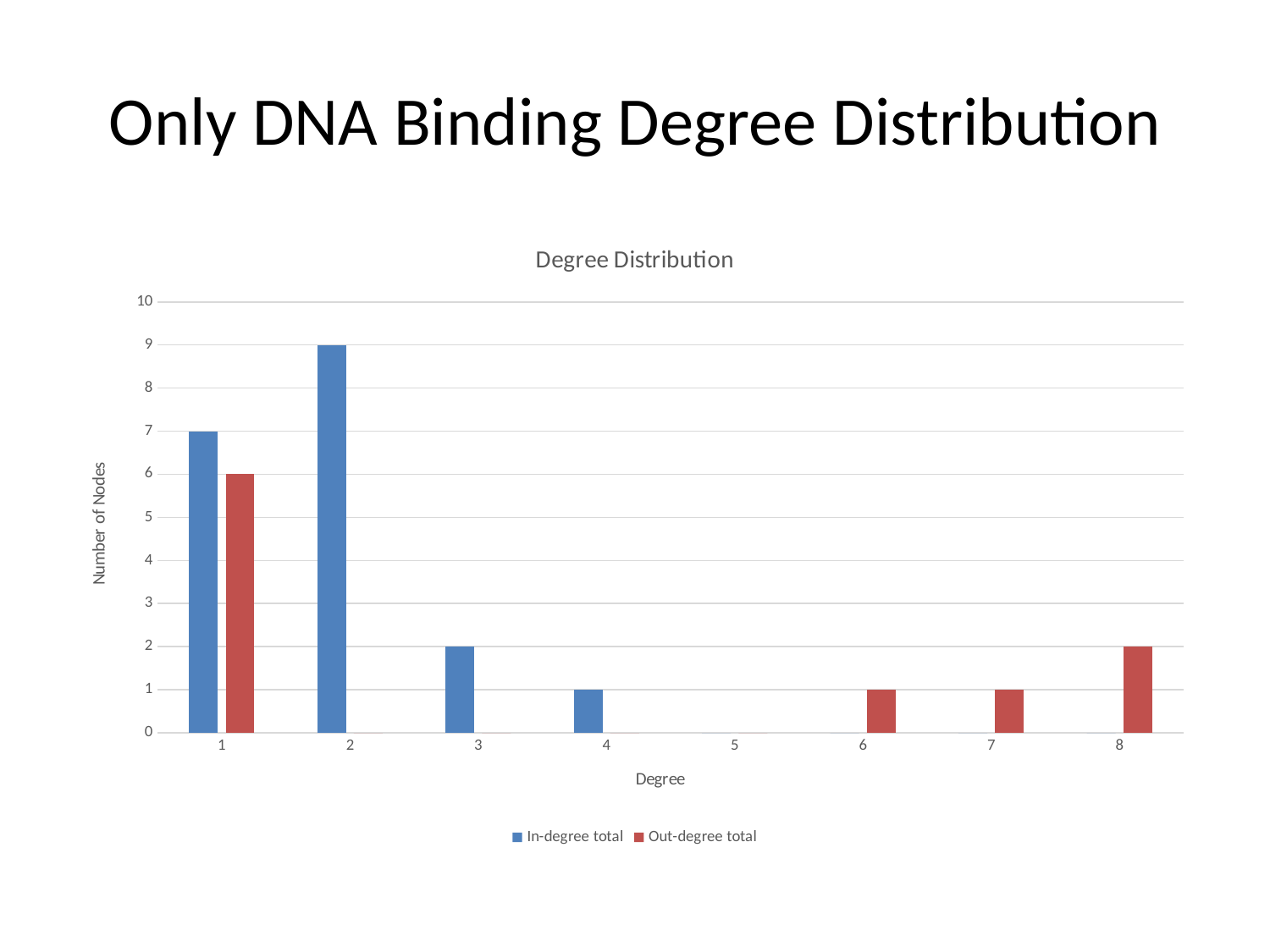
What is the In-degree total for degree 1? 7 What is the Out-degree total for degree 1? 6 Which degree has the highest In-degree total? 2 What is the difference between the In-degree total and the Out-degree total at degree 1? 1 How many degree categories are shown on the x axis? 8 What is the Out-degree total for degree 8? 2 What is the label of the y axis? Number of Nodes Which is larger at degree 1, the In-degree total or the Out-degree total? In-degree total How many series does the legend list? 2 What type of chart is shown on the slide? bar chart What is the In-degree total for degree 2? 9 What is the title of the chart? Degree Distribution